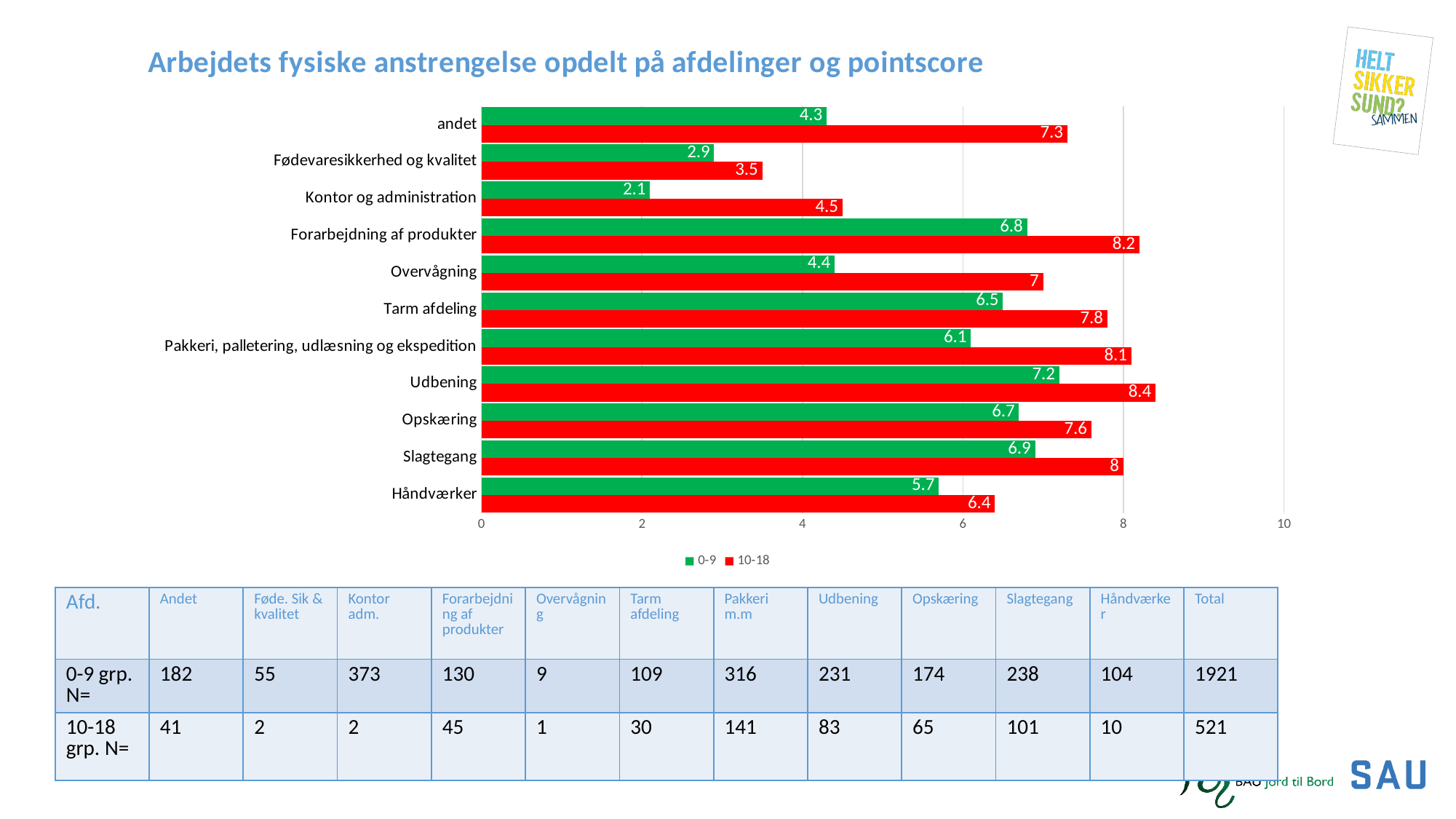
Which category has the highest value in the 10-18 series? Udbening Which category has the lowest value in the 10-18 series? Fødevaresikkerhed og kvalitet What is the value for Overvågning in the 10-18 series? 7 How many categories are shown on the chart? 11 Which category has the lowest value in the 0-9 series? Kontor og administration What is the value for Kontor og administration in the 0-9 series? 2.1 How many series does the legend list? 2 What kind of chart is shown on the slide? Bar chart What colour represents the 10-18 series? Red Which is larger for Håndværker: the 0-9 value or the 10-18 value? 10-18 What is the difference between the 10-18 and 0-9 values for Kontor og administration? 2.4 What is the value for Udbening in the 10-18 series? 8.4